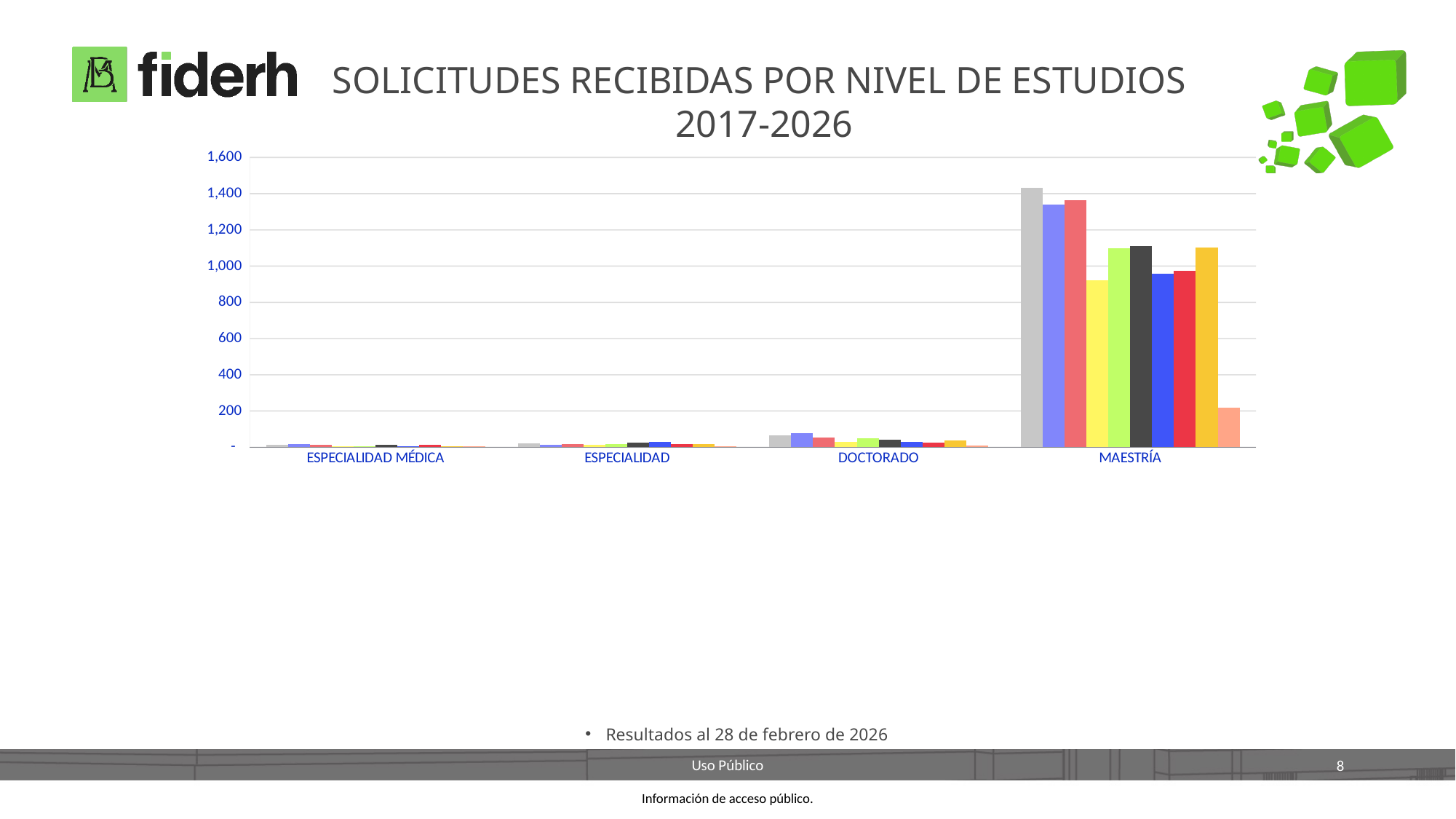
How many study-level categories are shown on the x axis? 4 Which category has taller bars, DOCTORADO or ESPECIALIDAD? DOCTORADO Is the shortest bar for MAESTRÍA greater or less than 400? less How many bars are plotted for the MAESTRÍA category? 10 Is the tallest bar for DOCTORADO greater or less than 200? less Which category has the lowest bars? ESPECIALIDAD MÉDICA Is the tallest bar for ESPECIALIDAD greater or less than 200? less Which category has the highest bars? MAESTRÍA What kind of chart is shown on the slide? Bar chart What is the title of the chart? SOLICITUDES RECIBIDAS POR NIVEL DE ESTUDIOS 2017-2026 What is the highest value shown on the vertical axis? 1,600